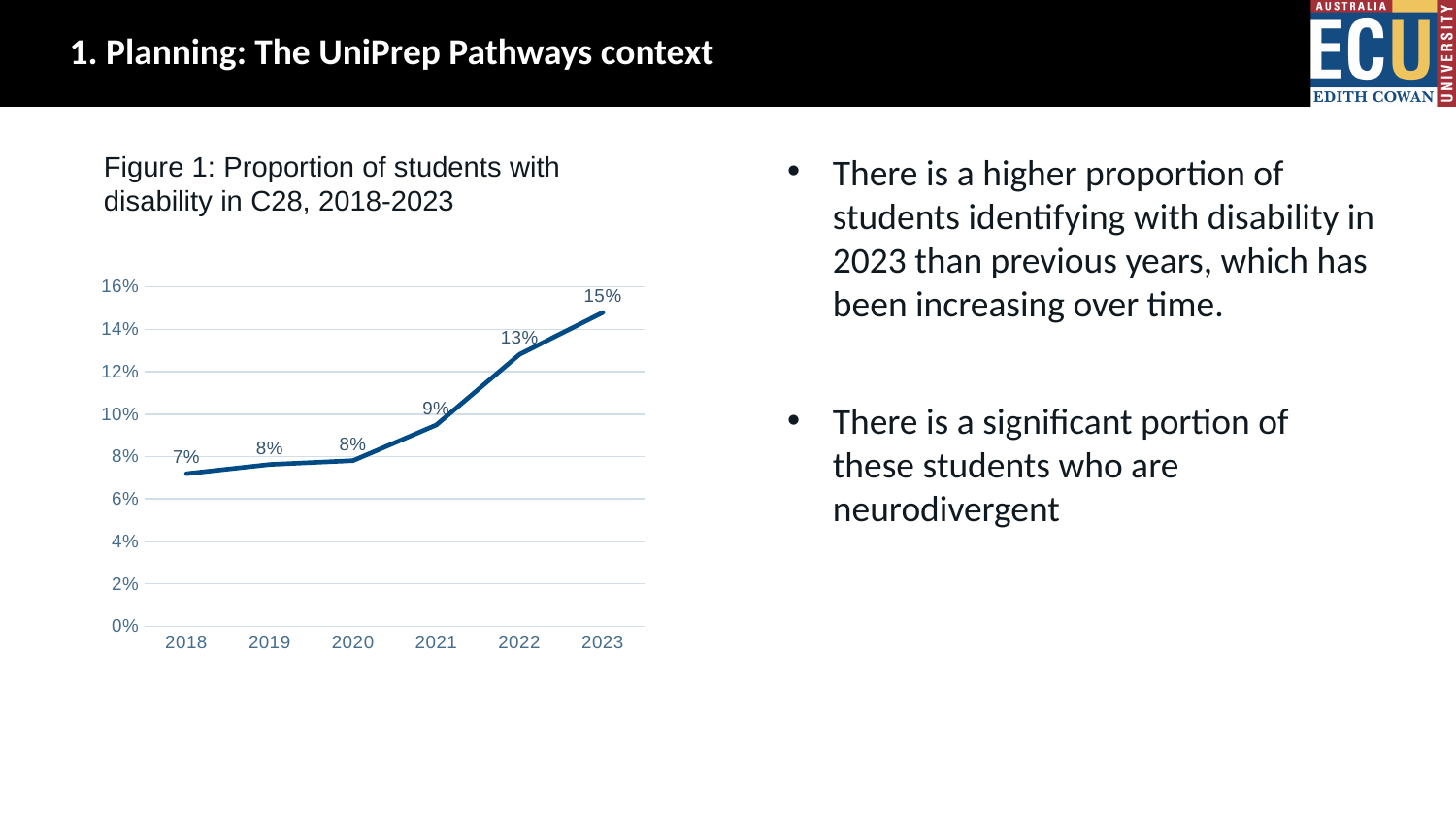
What kind of chart is shown on the slide? Line chart Do the values rise or fall from 2018 to 2023? Rise Which year has the lowest proportion of students with disability? 2018 What is the value shown for 2022? 13% What is the proportion of students with disability in 2023? 15% How many years are plotted on the chart? 6 Which year has the highest proportion of students with disability? 2023 Is the value for 2022 greater or less than 12%? greater What is the difference between the 2023 value and the 2018 value? 8% Which is larger, the value for 2022 or the value for 2021? 2022 What is the value shown for 2021? 9% What is the proportion of students with disability in 2018? 7%